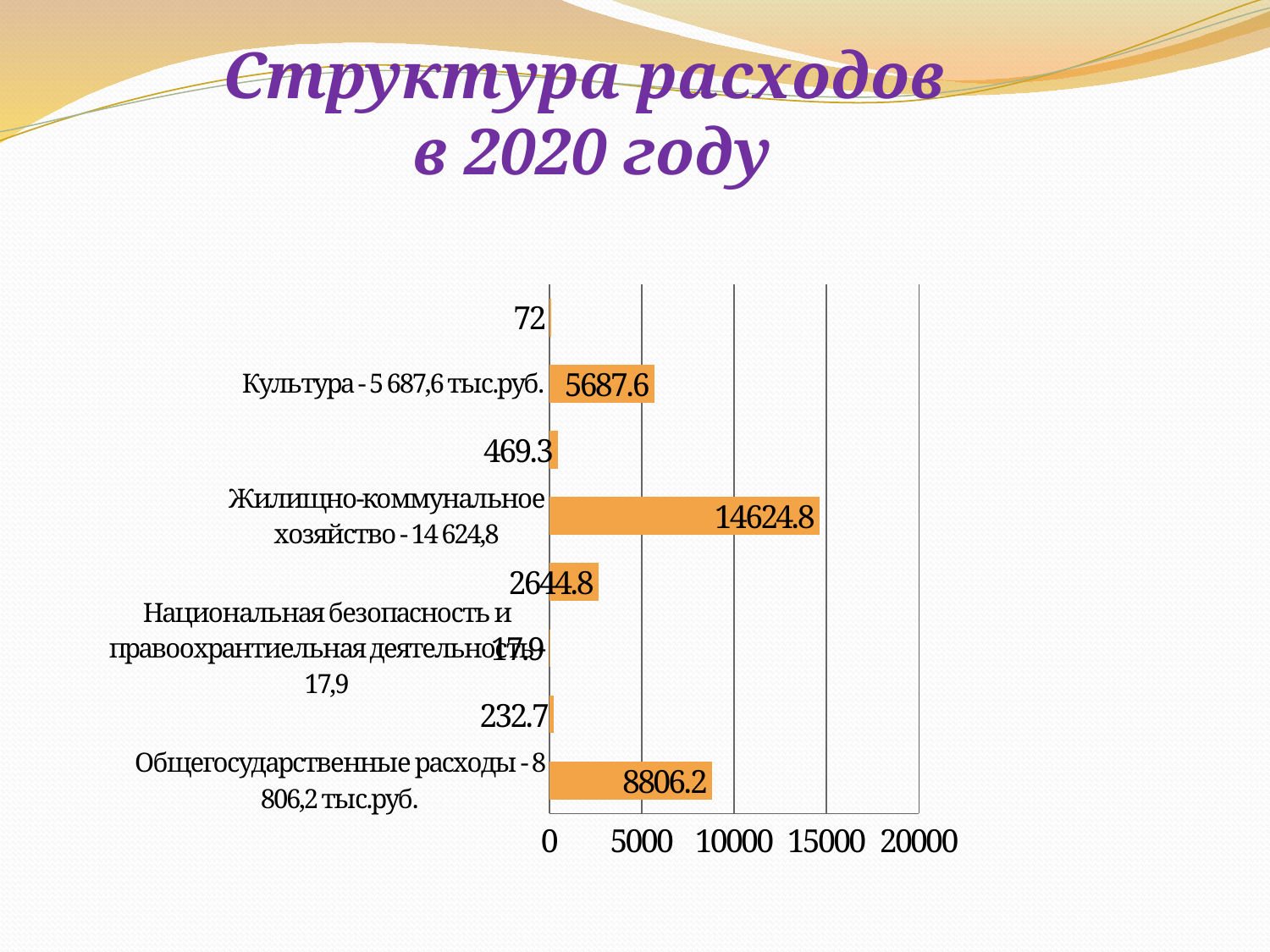
Which is larger: the value for Культура or the value for Общегосударственные расходы? Общегосударственные расходы What is the value shown for Жилищно-коммунальное хозяйство? 14624.8 What is the value shown for Общегосударственные расходы? 8806.2 Is the value for Культура greater or less than 5000? greater Which category has the highest value? Жилищно-коммунальное хозяйство How many bars are plotted in the chart? 8 What is the value shown for Культура? 5687.6 What is the value shown for Национальная безопасность и правоохранительная деятельность? 17.9 Which category has the lowest value? Национальная безопасность и правоохранительная деятельность What is the title of the slide? Структура расходов в 2020 году What kind of chart is shown on the slide? bar chart What is the difference between the values for Жилищно-коммунальное хозяйство and Общегосударственные расходы? 5818.6